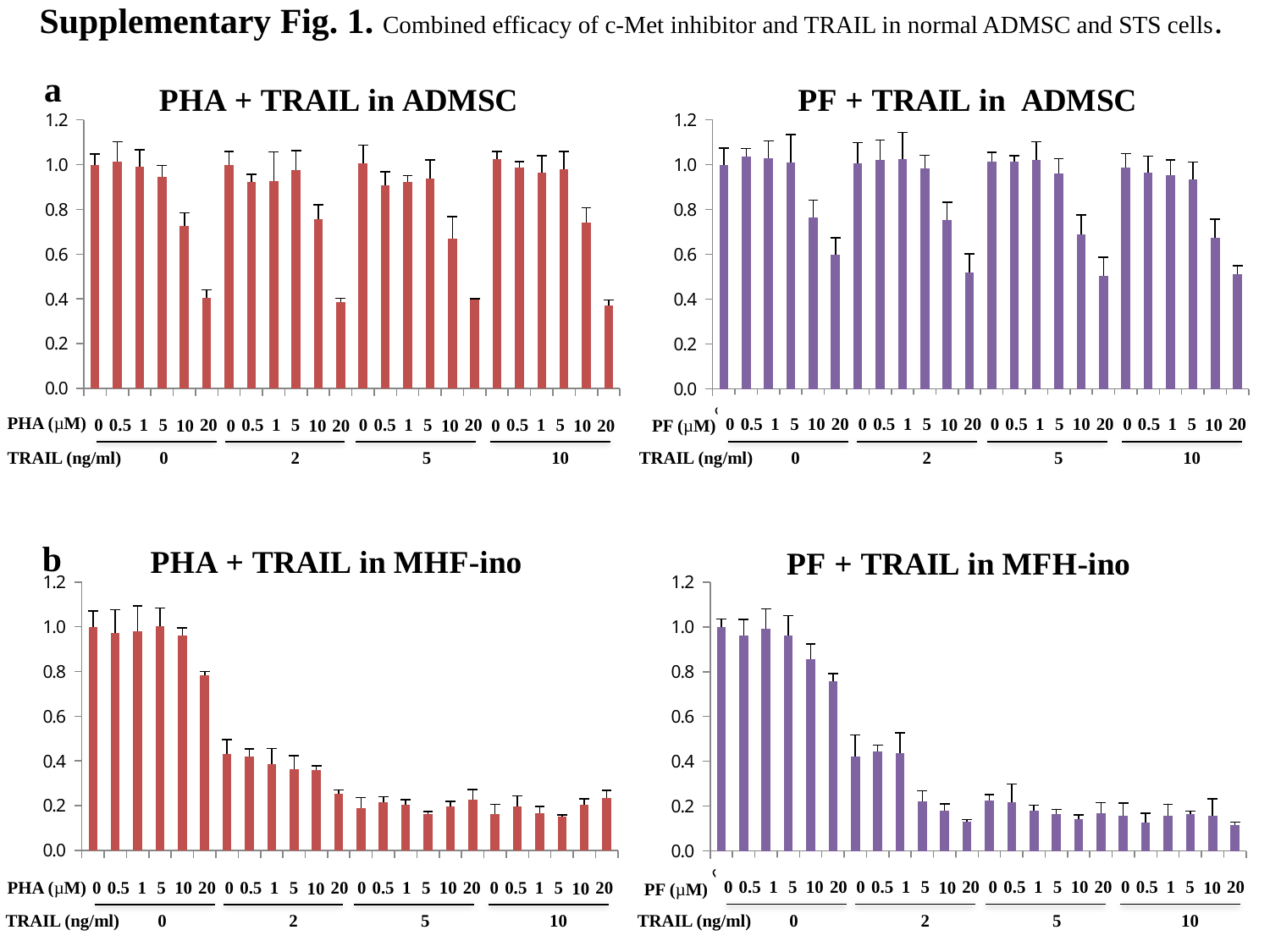
What type of chart is "PHA + TRAIL in ADMSC"? bar chart In the "PHA + TRAIL in ADMSC" chart, within the TRAIL 0 ng/ml group, which PHA concentration has the lowest bar? 20 µM In the "PF + TRAIL in MFH-ino" chart, how many PF concentrations are tested within each TRAIL group? 6 In the "PF + TRAIL in MFH-ino" chart, is the value for PF 20 µM at TRAIL 0 ng/ml greater or less than 0.6? greater In the "PF + TRAIL in MFH-ino" chart, which TRAIL group contains the highest bars? 0 ng/ml In the "PHA + TRAIL in ADMSC" chart, is the value for PHA 0 µM at TRAIL 0 ng/ml greater or less than 0.8? greater In the "PHA + TRAIL in MHF-ino" chart, do the bar values generally rise or fall from left to right along the x axis? fall In the "PHA + TRAIL in ADMSC" chart, how many TRAIL concentration groups are shown on the x axis? 4 In the "PHA + TRAIL in MHF-ino" chart, is the value for PHA 0 µM at TRAIL 2 ng/ml greater or less than 0.6? less In the "PF + TRAIL in ADMSC" chart, within the TRAIL 0 ng/ml group, which is larger: the value for PF 0 µM or PF 20 µM? PF 0 µM What colour are the bars in the "PF + TRAIL in ADMSC" chart? purple